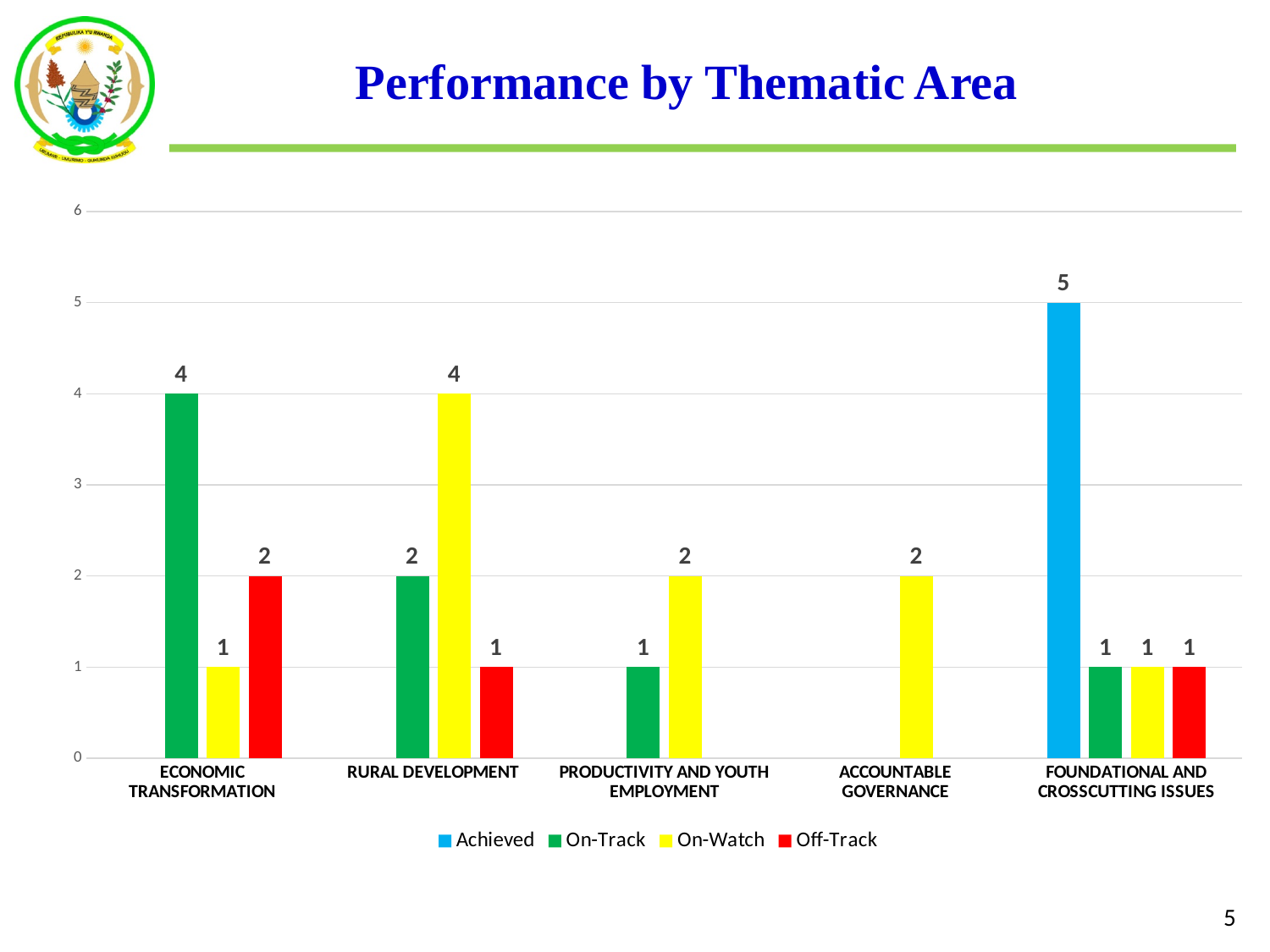
What is the On-Watch value for Accountable Governance? 2 How many thematic areas are shown on the x axis? 5 What is the On-Watch value for Rural Development? 4 What kind of chart is shown on the slide? Bar chart Which is larger: the Off-Track value for Economic Transformation or the Off-Track value for Rural Development? Economic Transformation What is the Achieved value for Foundational and Crosscutting Issues? 5 Which thematic area has the highest Achieved value? Foundational and Crosscutting Issues What is the On-Track value for Economic Transformation? 4 What colour represents the Off-Track series in the legend? Red What is the difference between the On-Track value for Economic Transformation and the On-Track value for Rural Development? 2 How many series does the legend list? 4 Which thematic area has the highest On-Watch value? Rural Development